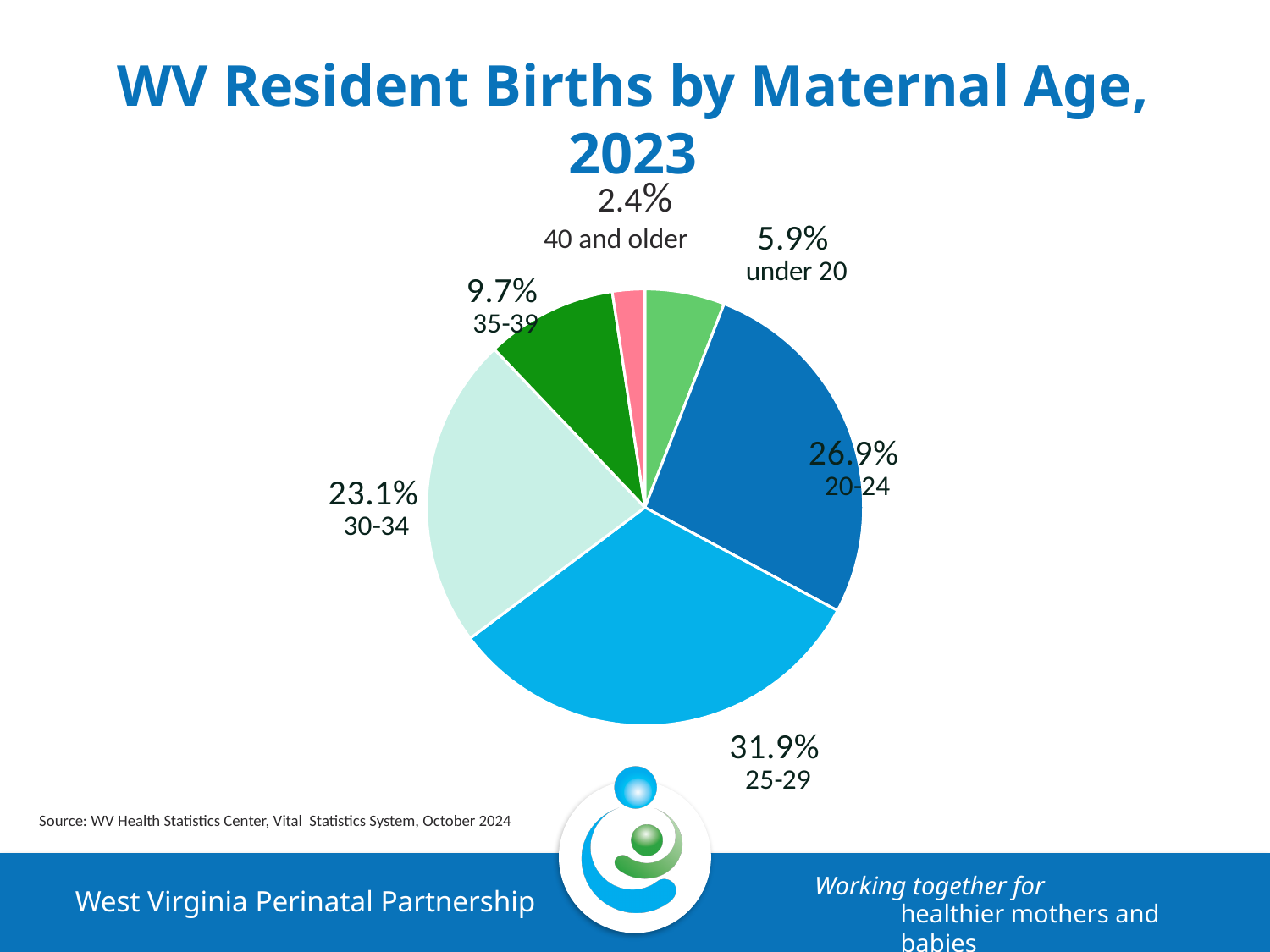
What is the difference in percentage points between the 25-29 and 20-24 age groups? 5.0 Which maternal age group accounts for the largest share of births? 25-29 What percentage of births were to mothers under 20? 5.9% How many maternal age groups are shown in the pie chart? 6 Which age group has a larger share of births, 35-39 or under 20? 35-39 What is the title of the chart? WV Resident Births by Maternal Age, 2023 What percentage of births were to mothers aged 40 and older? 2.4% Which maternal age group accounts for the smallest share of births? 40 and older What type of chart is shown on the slide? pie chart What share of WV resident births in 2023 were to mothers aged 25-29? 31.9% What percentage of births were to mothers aged 30-34? 23.1% What share of births were to mothers aged 20-24? 26.9%